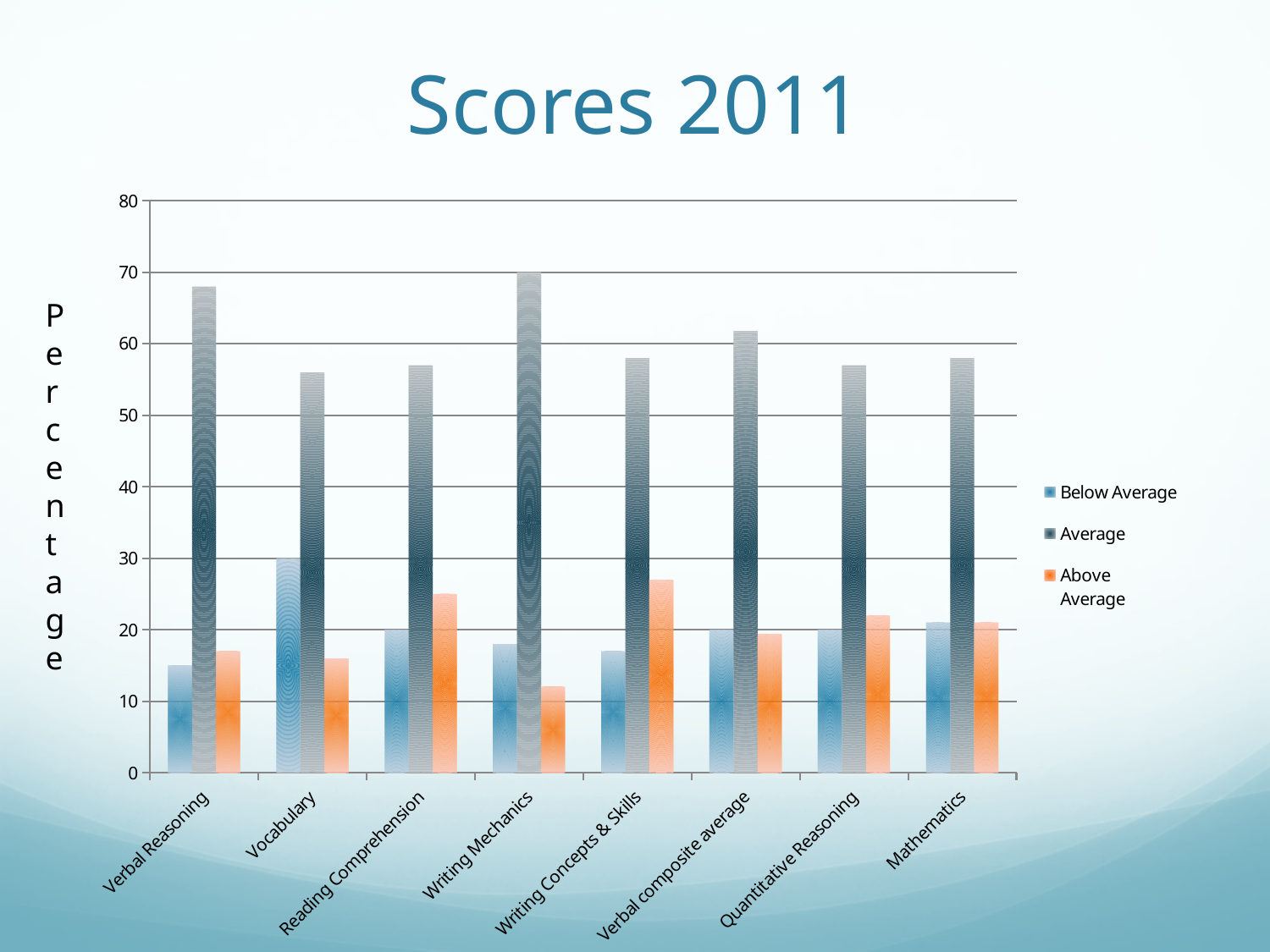
Is the Average value for Verbal Reasoning greater or less than 60? greater What is the title of the chart? Scores 2011 How many categories are shown on the x axis? 8 Which category has the highest Average value? Writing Mechanics Is the Below Average value for Verbal Reasoning greater or less than 20? less What kind of chart is shown on the slide? bar chart Which is larger for Vocabulary, the Below Average value or the Above Average value? Below Average Which is larger for Writing Concepts & Skills, the Below Average value or the Above Average value? Above Average How many series does the legend list? 3 Which category has the highest Below Average value? Vocabulary Is the Above Average value for Reading Comprehension greater or less than 20? greater Which category has the lowest Above Average value? Writing Mechanics